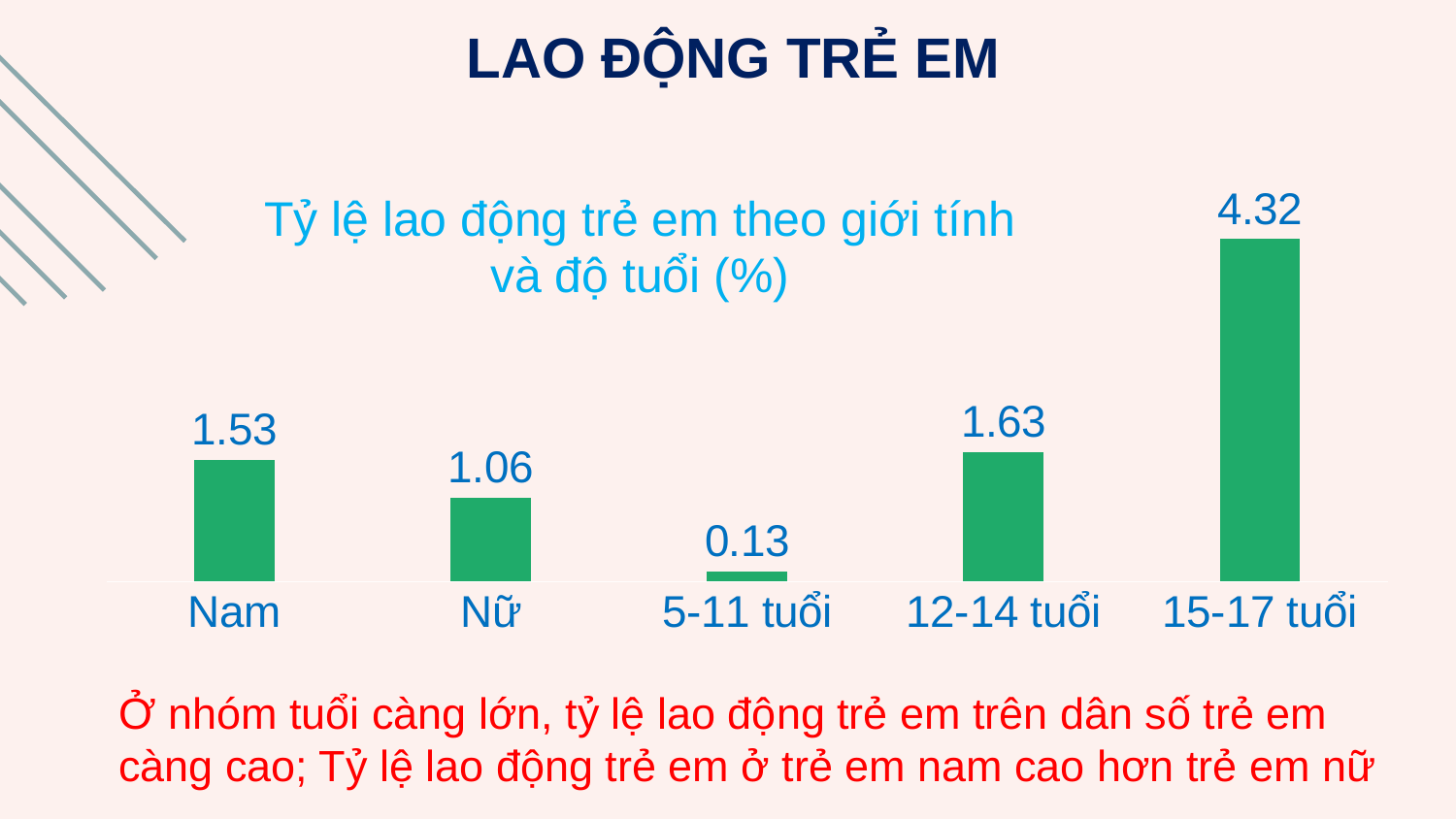
What is the value for Nữ? 1.06 What is the value for Nam? 1.53 What is the value for 12-14 tuổi? 1.63 What is the value for 15-17 tuổi? 4.32 What is the difference between the values for Nam and Nữ? 0.47 Which category has the lowest value? 5-11 tuổi What is the difference between the values for 15-17 tuổi and 12-14 tuổi? 2.69 Which category has the highest value? 15-17 tuổi Which is larger, the value for Nam or the value for Nữ? Nam How many categories are shown in the chart? 5 What is the value for 5-11 tuổi? 0.13 What type of chart is shown on the slide? Bar chart